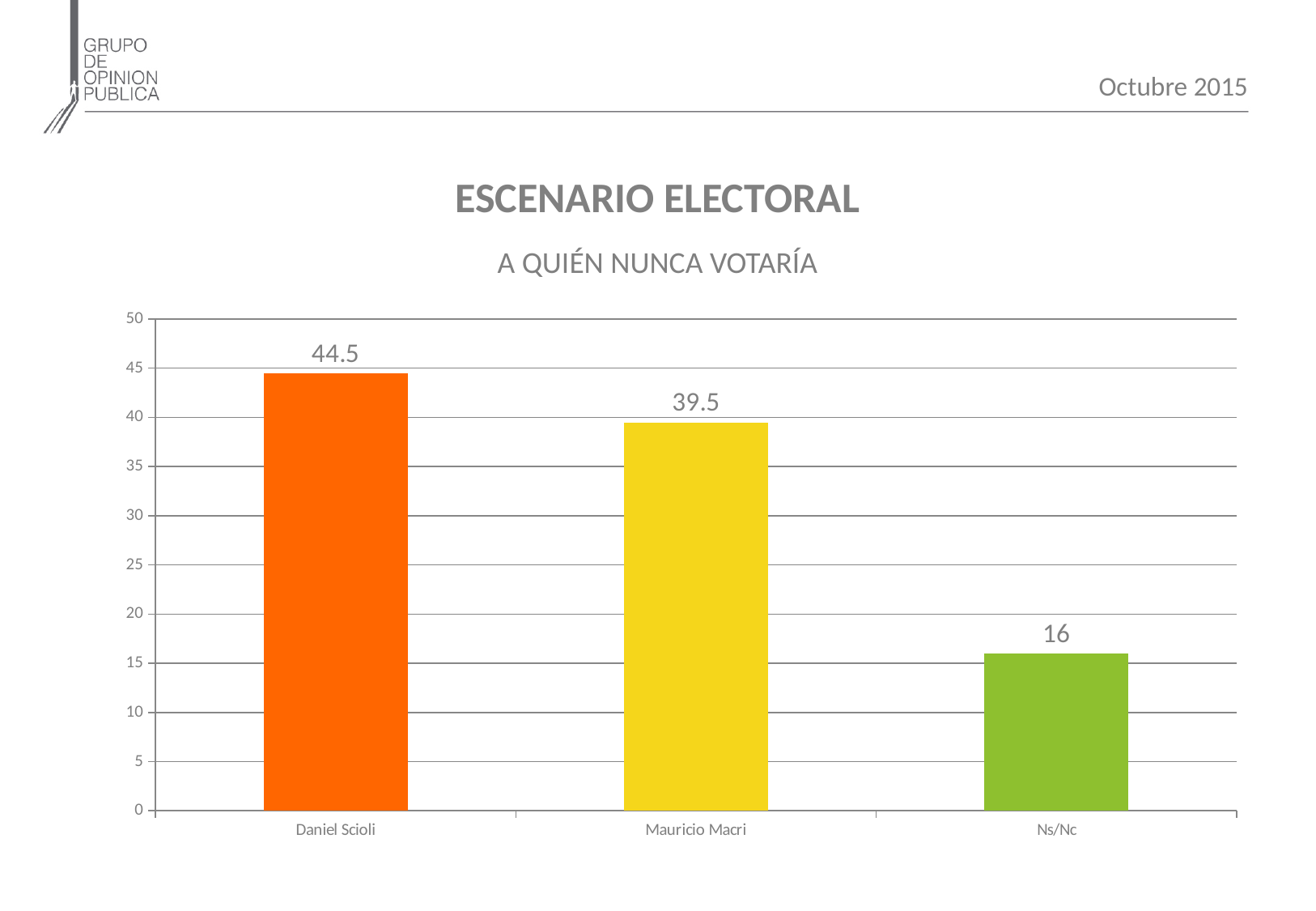
What is the difference between the values for Mauricio Macri and Ns/Nc? 23.5 Which category has the highest value? Daniel Scioli Is the value for Mauricio Macri greater or less than 40? less Which is larger, the value for Mauricio Macri or the value for Ns/Nc? Mauricio Macri How many categories are shown on the chart? 3 What is the subtitle of the chart below 'ESCENARIO ELECTORAL'? A QUIÉN NUNCA VOTARÍA What is the value for Ns/Nc? 16 What is the difference between the values for Daniel Scioli and Mauricio Macri? 5 What is the value for Daniel Scioli? 44.5 Which category has the lowest value? Ns/Nc What kind of chart is shown on the slide? bar chart What is the value for Mauricio Macri? 39.5